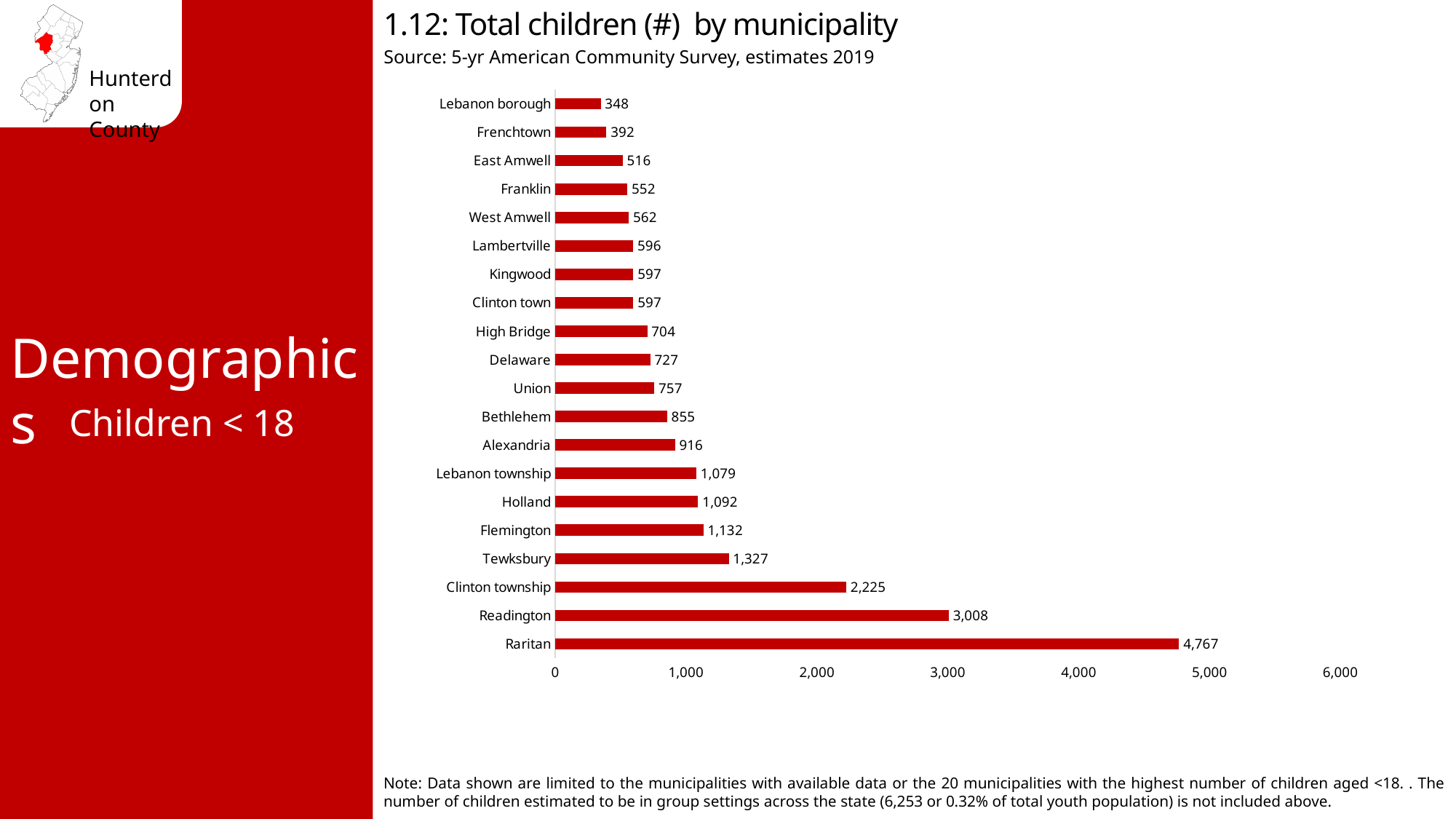
How many municipalities are shown in the chart? 20 What is the difference in the number of children between Raritan and Readington? 1,759 Which municipality has the highest number of children? Raritan What type of chart is used to show total children by municipality? Bar chart What is the difference in the number of children between Tewksbury and Flemington? 195 What is the source of the data shown in the chart? 5-yr American Community Survey, estimates 2019 What is the total number of children in Raritan? 4,767 Which has more children, Clinton township or Readington? Readington What is the total number of children in Lambertville? 596 Which municipality has the lowest number of children? Lebanon borough What is the total number of children in Flemington? 1,132 Which has more children, Bethlehem or Union? Bethlehem